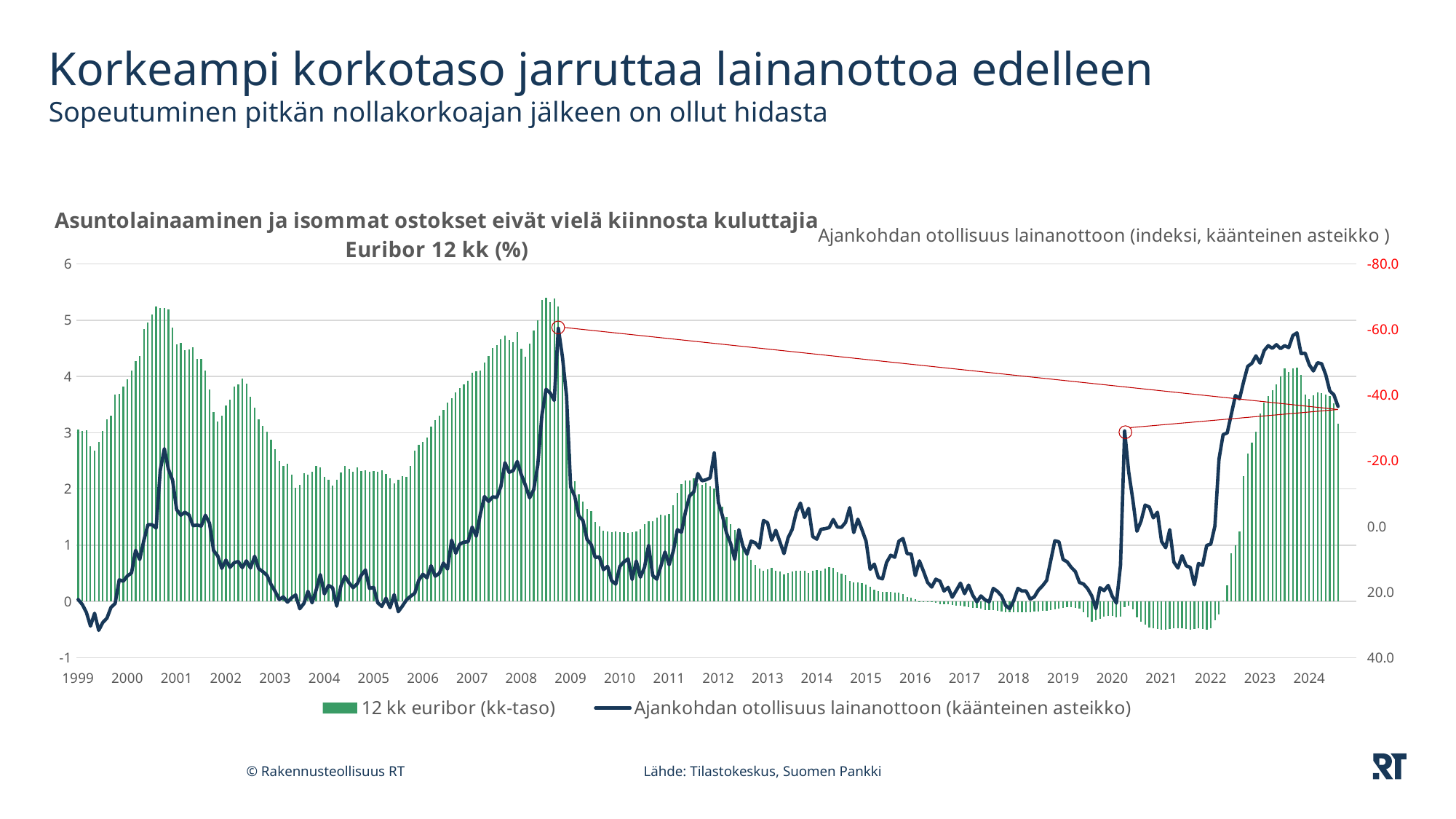
What kind of chart is shown on the slide? A combined bar and line chart Which is larger, the 12 kk euribor in 2023 or in 2016? 2023 Do the 12 kk euribor bars rise or fall from 2008 to 2009? fall How many series does the chart legend list? 2 Which series is drawn as green bars according to the legend? 12 kk euribor (kk-taso) Is the 12 kk euribor value at its 2000 peak greater or less than 5? greater Is the 12 kk euribor value in 2021 greater or less than 0? less Do the 12 kk euribor bars rise or fall from 2022 to 2023? rise What is the title of the chart? Asuntolainaaminen ja isommat ostokset eivät vielä kiinnosta kuluttajia Euribor 12 kk (%) Is the 12 kk euribor value in 2016 greater or less than 1? less